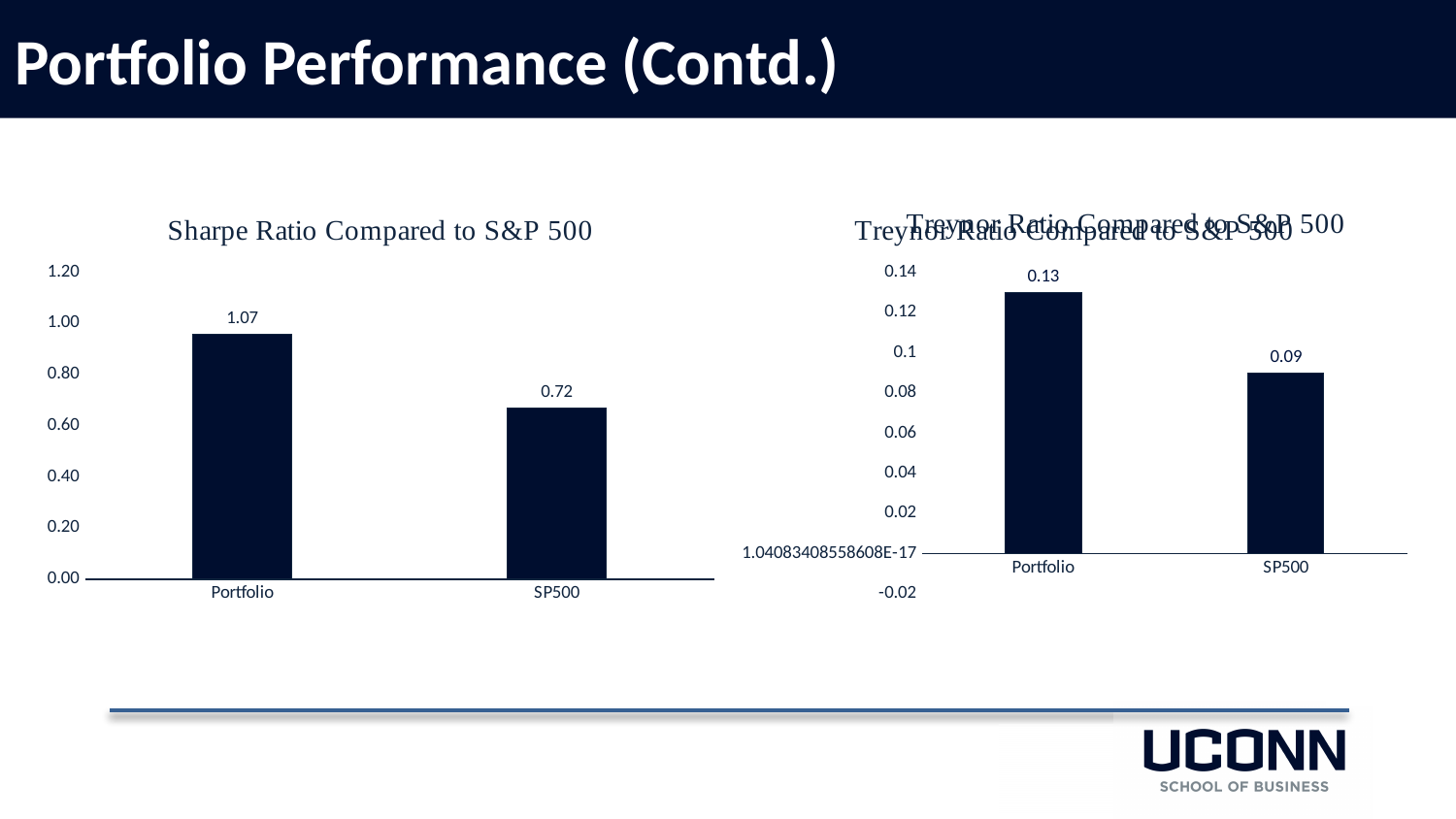
In the Sharpe Ratio Compared to S&P 500 chart, what is the value for SP500? 0.72 In the Treynor Ratio Compared to S&P 500 chart, what is the difference between the Portfolio and SP500 values? 0.04 In the Treynor Ratio Compared to S&P 500 chart, which is larger, Portfolio or SP500? Portfolio What kind of chart is the Treynor Ratio Compared to S&P 500 chart? Bar chart How many categories are shown in the Sharpe Ratio Compared to S&P 500 chart? 2 In the Sharpe Ratio Compared to S&P 500 chart, what is the difference between the Portfolio and SP500 values? 0.35 In the Treynor Ratio Compared to S&P 500 chart, what is the value for SP500? 0.09 In the Sharpe Ratio Compared to S&P 500 chart, what is the value for Portfolio? 1.07 In the Treynor Ratio Compared to S&P 500 chart, which category has the lowest value? SP500 What is the title of the chart on the left side of the slide? Sharpe Ratio Compared to S&P 500 In the Treynor Ratio Compared to S&P 500 chart, what is the value for Portfolio? 0.13 In the Sharpe Ratio Compared to S&P 500 chart, which category has the highest value? Portfolio